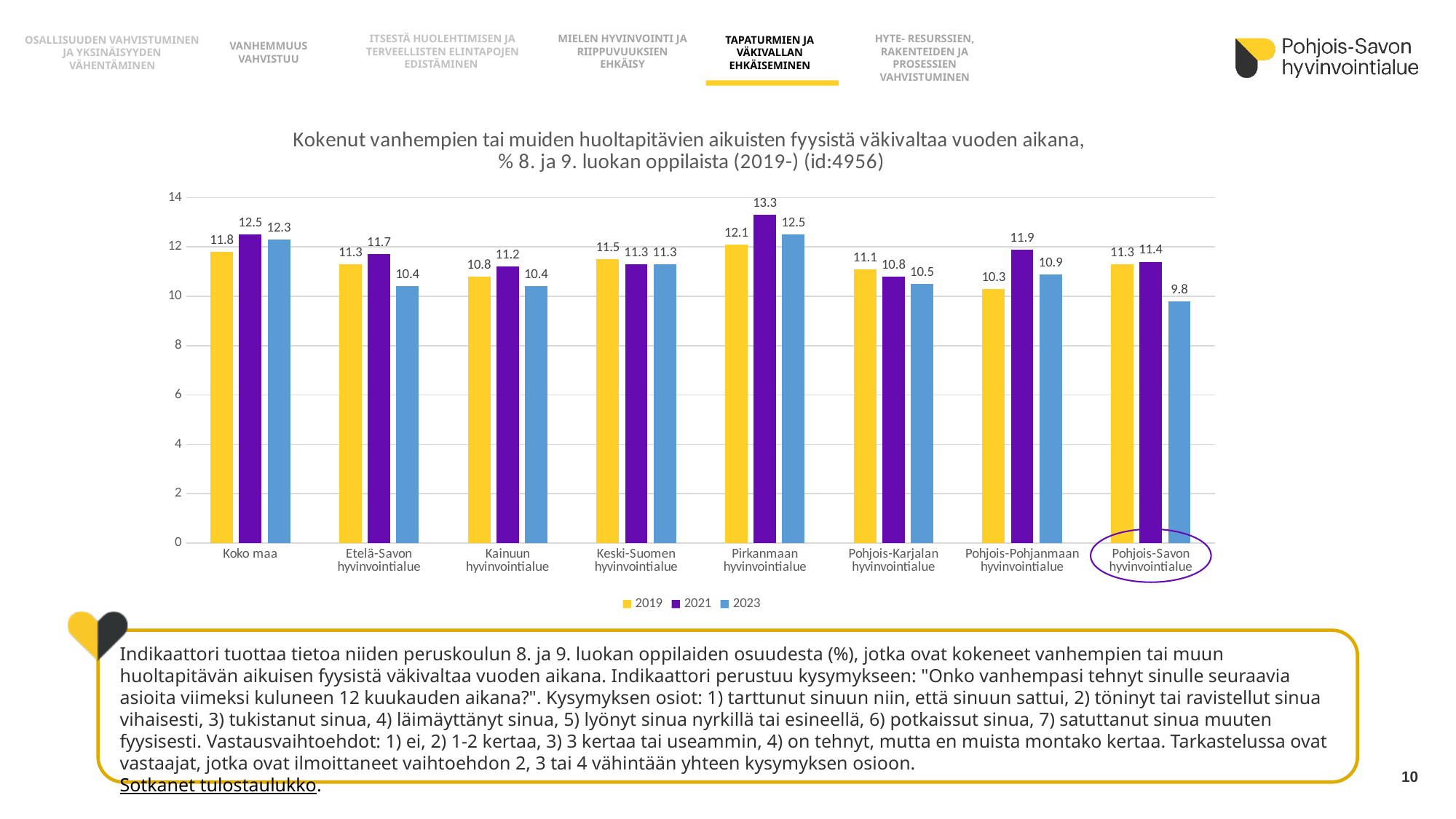
What is the value for Pohjois-Savon hyvinvointialue in 2023? 9.8 What kind of chart is shown on the slide? Bar chart Which category has the lowest 2023 value? Pohjois-Savon hyvinvointialue What is the difference between the 2021 and 2023 values for Pohjois-Savon hyvinvointialue? 1.6 What is the 2019 value for Koko maa? 11.8 Which series is shown in yellow in the legend? 2019 What is the value for Pirkanmaan hyvinvointialue in 2021? 13.3 Which category has the lowest 2019 value? Pohjois-Pohjanmaan hyvinvointialue Which is larger for Kainuun hyvinvointialue: the 2019 value or the 2021 value? 2021 How many categories are shown on the x axis? 8 Which category has the highest 2021 value? Pirkanmaan hyvinvointialue How many series does the legend list? 3